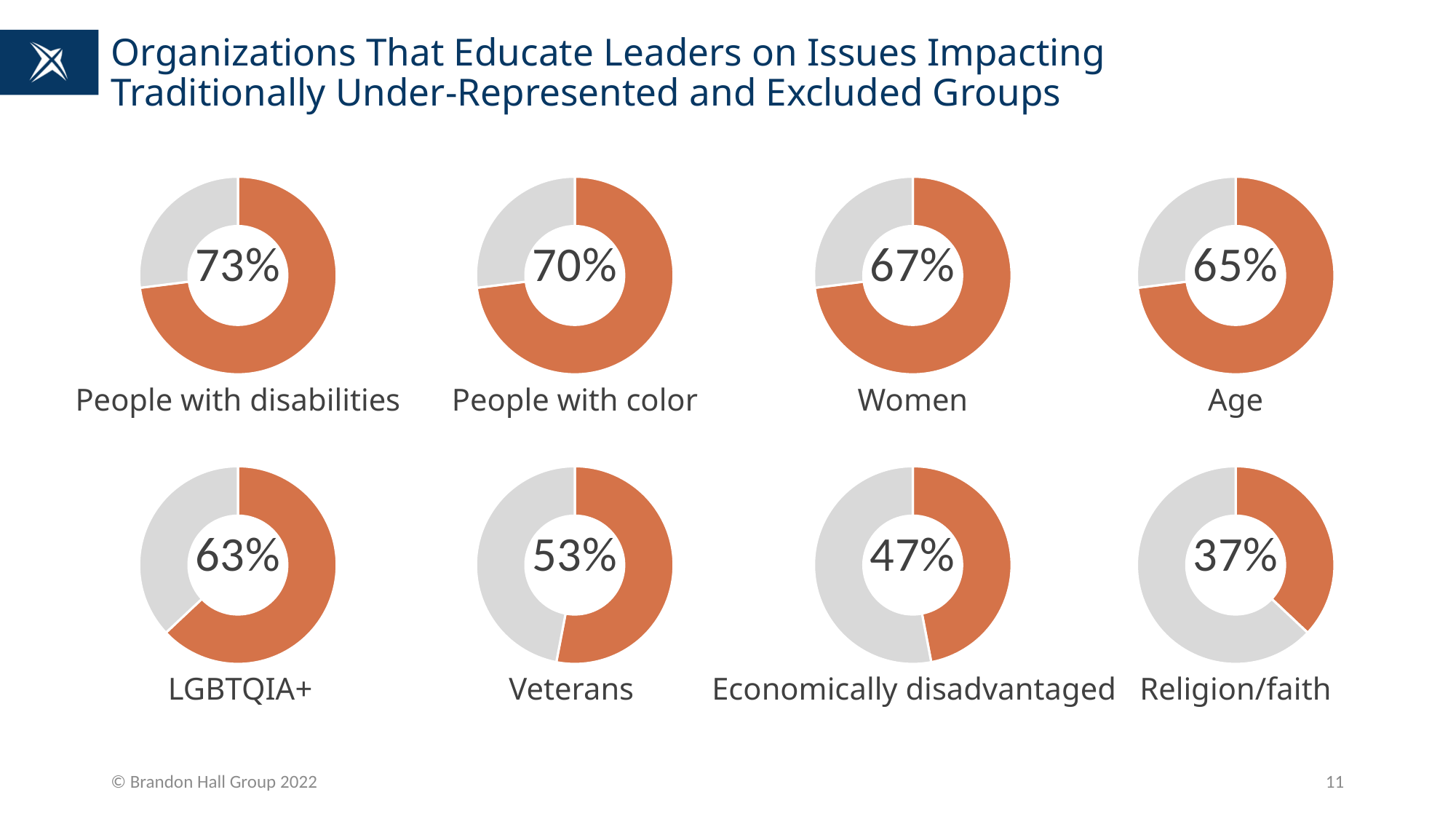
What percentage is shown in the donut chart labeled 'Religion/faith'? 37% What percentage is shown in the donut chart labeled 'Women'? 67% What is the difference in percentage points between the 'People with disabilities' chart and the 'Religion/faith' chart? 36 What percentage is shown in the donut chart labeled 'Veterans'? 53% How many donut charts are shown on the slide? 8 What kind of chart is used to display each group's percentage on the slide? Donut chart Which group has the lowest percentage across the donut charts on the slide? Religion/faith What is the difference in percentage points between the 'People with color' chart and the 'Age' chart? 5 What percentage is shown in the donut chart labeled 'People with disabilities'? 73% Which is larger, the percentage for 'LGBTQIA+' or the percentage for 'Economically disadvantaged'? LGBTQIA+ Which group has the highest percentage across the donut charts on the slide? People with disabilities What colour is used for the filled (percentage) portion of each donut chart? Orange